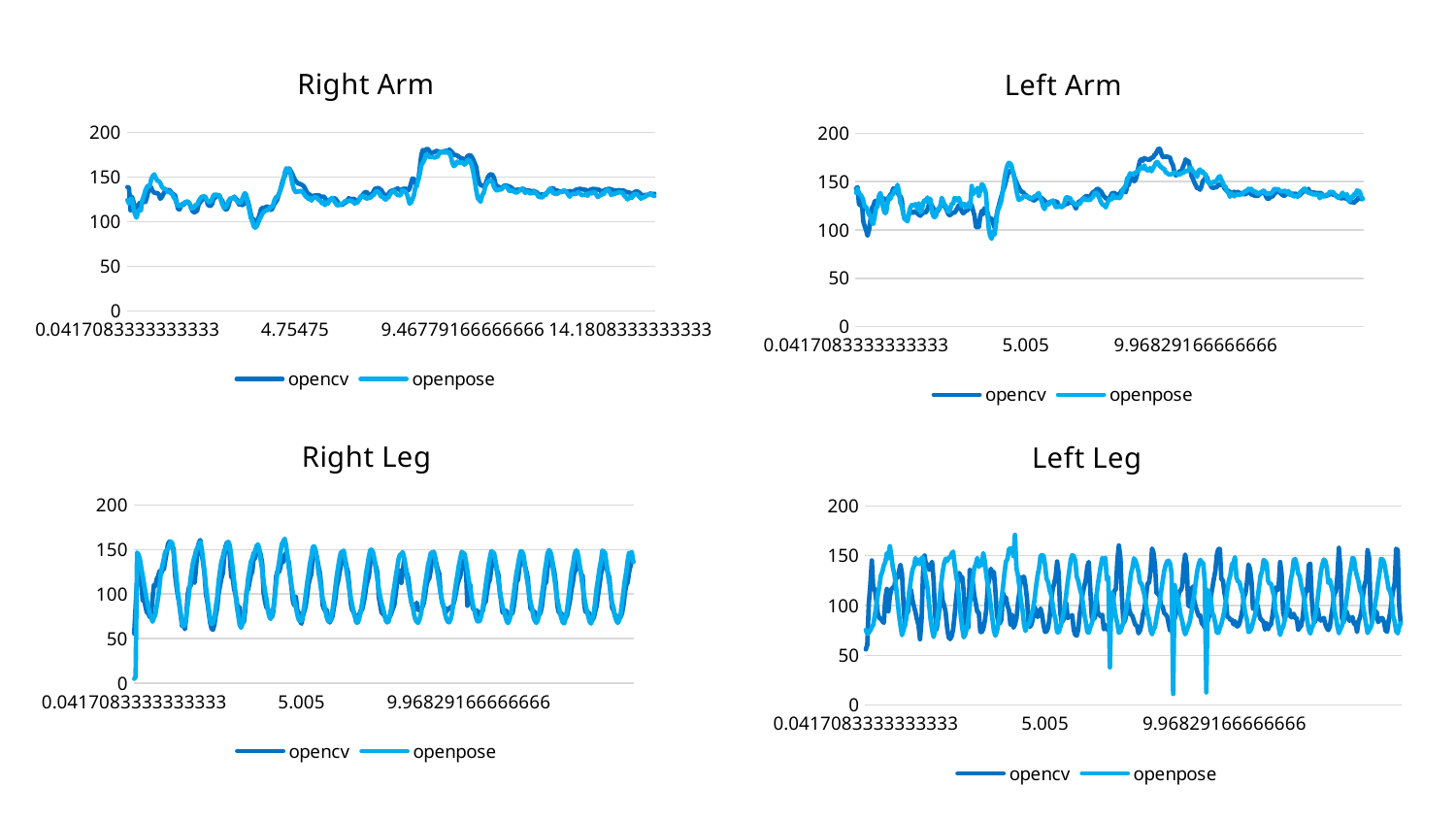
In the "Right Leg" chart, do the peaks of the lines go above 200? No How many series does the legend of the "Left Leg" chart list? 2 In the "Left Arm" chart, is the lowest value of the openpose line greater or less than 150? less In the "Right Leg" chart, is the lowest value of the openpose line greater or less than 50? less What kind of chart is the "Left Leg" chart? line chart How many charts are shown on the slide? 4 What are the two series named in the legend of the "Right Arm" chart? opencv and openpose What kind of chart is the "Right Arm" chart? line chart What is the highest value shown on the y axis of the "Left Arm" chart? 200